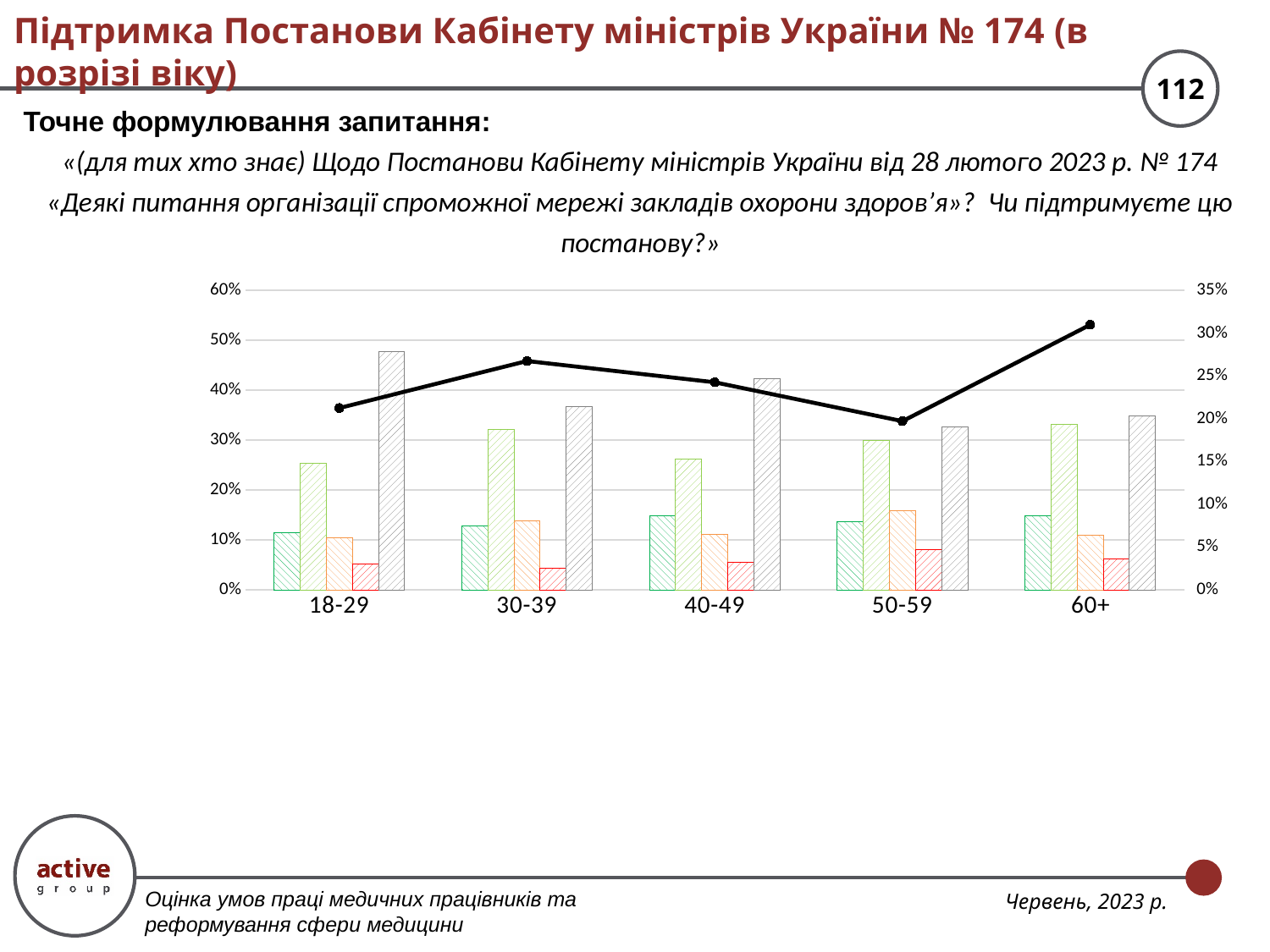
Which age group has the tallest grey hatched bar? 18-29 How many bars are plotted for each age group? 5 How many age groups are shown on the x axis of the chart? 5 Is the value of the teal bar for 60+ greater or less than 20%? less For the 40-49 group, which is taller: the grey hatched bar or the green bar? grey hatched bar Is the value of the grey hatched bar for 18-29 greater or less than 40%? greater What kind of chart is shown on the slide? bar chart with a line Does the black line rise or fall from 50-59 to 60+? rise At which age group does the black line reach its highest point? 60+ Is the value of the red bar for 18-29 greater or less than 10%? less What is the highest tick value shown on the right-hand axis? 35%